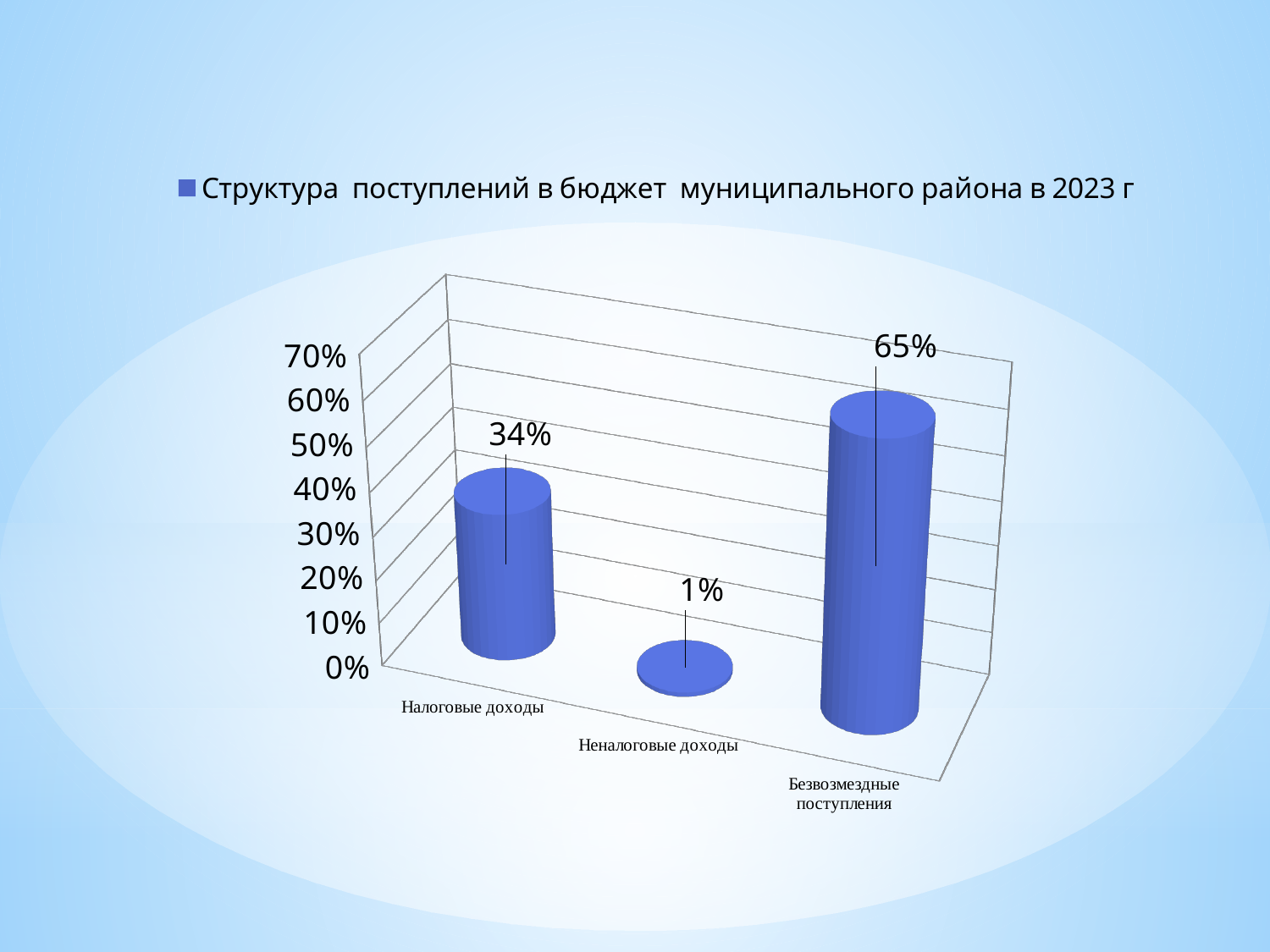
Which category has the highest value? Безвозмездные поступления What is the value for Неналоговые доходы? 1% How many series does the legend list? 1 What is the difference between the values for Безвозмездные поступления and Налоговые доходы? 31% What is the difference between the values for Налоговые доходы and Неналоговые доходы? 33% What is the value for Налоговые доходы? 34% How many categories are shown on the chart? 3 What is the legend entry shown above the chart? Структура поступлений в бюджет муниципального района в 2023 г Which category has the lowest value? Неналоговые доходы Which is larger, the value for Налоговые доходы or the value for Безвозмездные поступления? Безвозмездные поступления What kind of chart is shown on the slide? Bar chart What is the value for Безвозмездные поступления? 65%